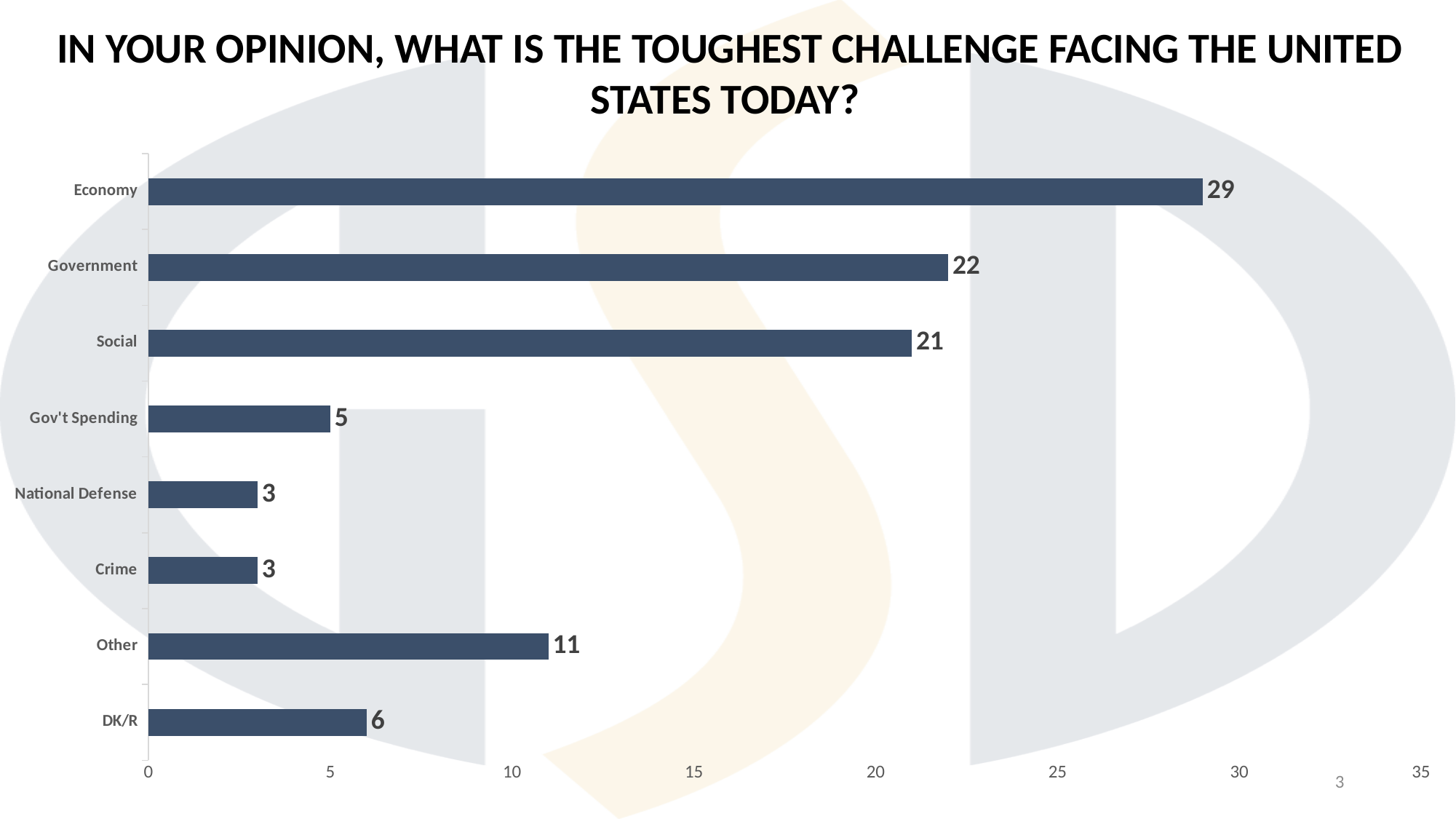
What is the value for Economy? 29 What kind of chart is shown on the slide? Bar chart What is the value for Other? 11 What is the difference between the values for Social and Gov't Spending? 16 How many categories are shown in the chart? 8 Which category has the highest value? Economy What is the difference between the values for Economy and Government? 7 Which is larger, the value for Other or the value for DK/R? Other Is the value for Social greater or less than 20? greater What is the value for DK/R? 6 What is the title of the chart? In your opinion, what is the toughest challenge facing the United States today? What is the value for Government? 22